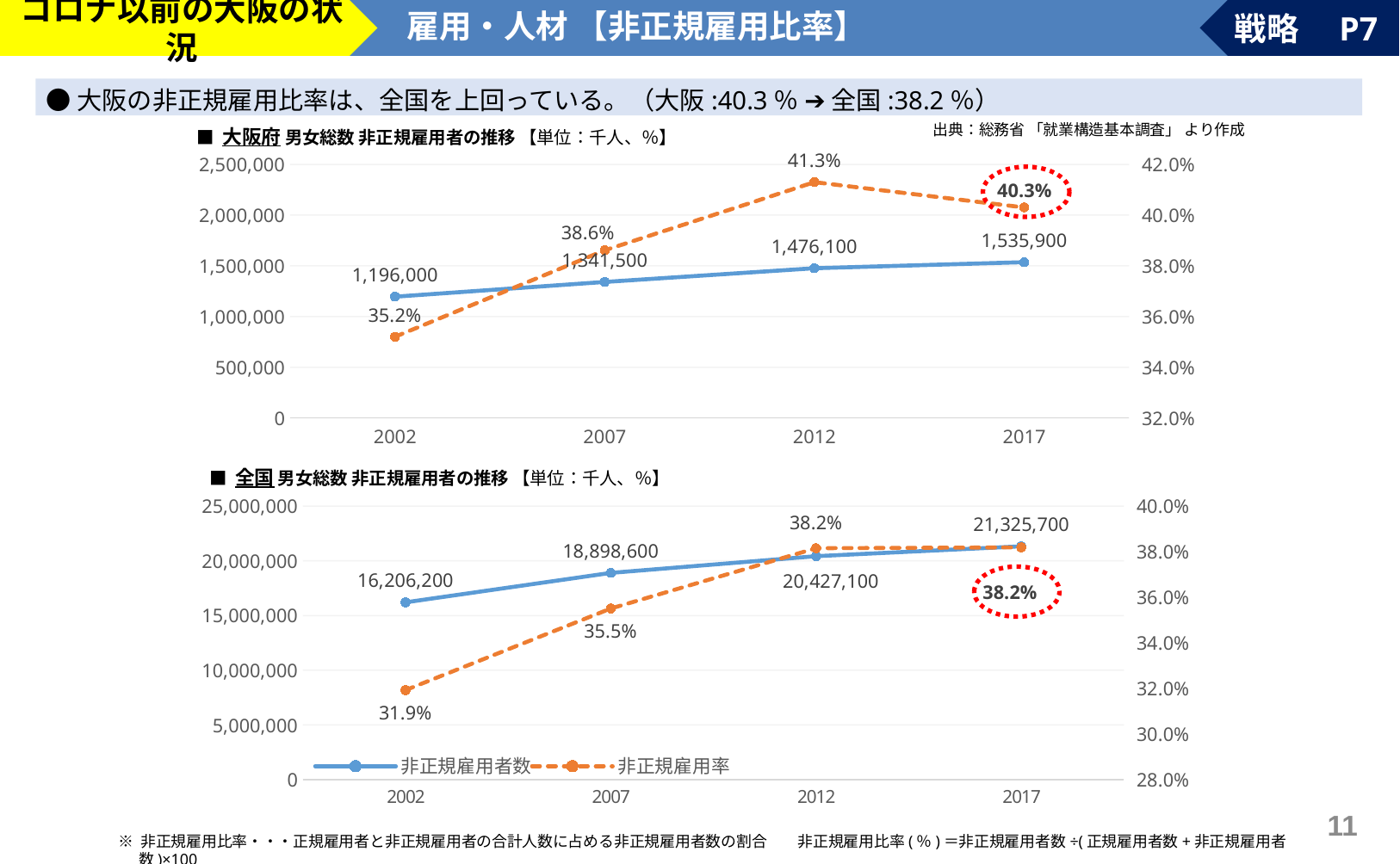
In the top chart (大阪府), what is the difference in the number of non-regular employees between 2017 and 2002? 339,900 In the top chart (大阪府), which year has the highest non-regular employment rate? 2012 How many years are plotted on the x axis of the top chart (大阪府)? 4 In the top chart (大阪府), what is the number of non-regular employees (非正規雇用者数) in 2017? 1,535,900 In the top chart (大阪府), which year has the lowest number of non-regular employees? 2002 In the bottom chart (全国), what is the difference in the non-regular employment rate between 2007 and 2002? 3.6% In the top chart (大阪府), what is the non-regular employment rate (非正規雇用率) in 2012? 41.3% Which is larger: the 2017 non-regular employment rate in the top chart (大阪府) or in the bottom chart (全国)? 大阪府 (40.3%) In the bottom chart (全国), does the number of non-regular employees rise or fall from 2002 to 2017? rise How many series does the legend of the bottom chart (全国) list? 2 In the bottom chart (全国), what is the number of non-regular employees in 2007? 18,898,600 In the bottom chart (全国), what is the non-regular employment rate in 2002? 31.9%